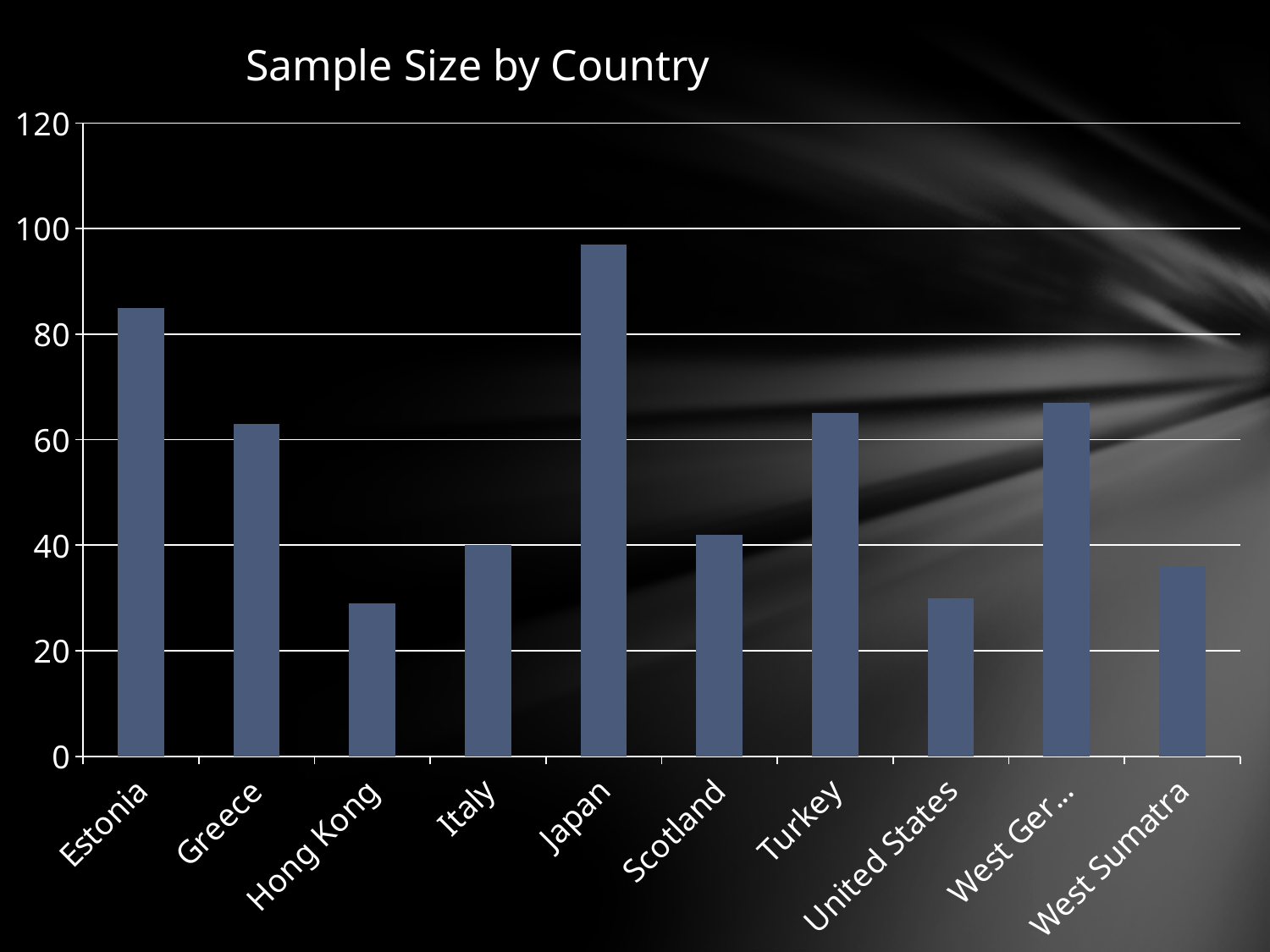
Is the sample size for Japan greater or less than 80? greater Which has a larger sample size, Estonia or Greece? Estonia Which has a larger sample size, Turkey or Scotland? Turkey Which country has the largest sample size? Japan Which has a larger sample size, West Sumatra or Japan? Japan Is the sample size for Hong Kong greater or less than 40? less What kind of chart is shown on the slide? bar chart How many countries are shown on the x axis of the chart? 10 Is the sample size for United States greater or less than 40? less What is the title of the chart? Sample Size by Country